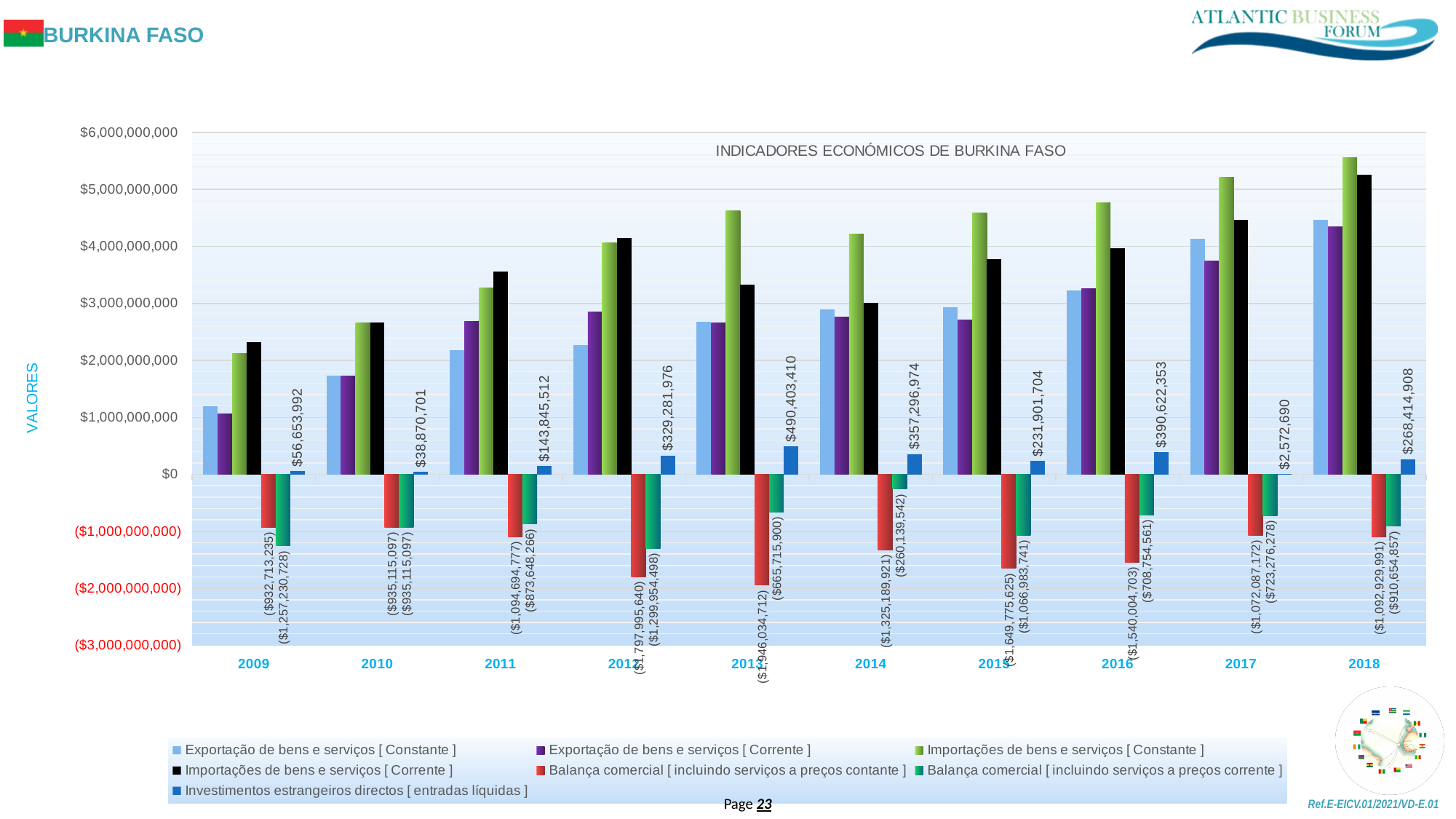
What is the title of the chart? INDICADORES ECONÓMICOS DE BURKINA FASO What is the difference between Investimentos estrangeiros directos [entradas líquidas] in 2013 and in 2014? $133,106,436 How many years are shown on the x axis? 10 In which year is Investimentos estrangeiros directos [entradas líquidas] lowest? 2017 What is the value of Balança comercial [incluindo serviços a preços corrente] in 2014? ($260,139,542) How many series does the legend list? 7 In which year is Investimentos estrangeiros directos [entradas líquidas] highest? 2013 What is the value of Balança comercial [incluindo serviços a preços contante] in 2012? ($1,797,995,640) Does Importações de bens e serviços [Constante] generally rise or fall from 2009 to 2018? Rise What kind of chart is shown on the slide? Bar chart Is the value of Importações de bens e serviços [Constante] in 2018 greater or less than $5,000,000,000? greater What is the value of Investimentos estrangeiros directos [entradas líquidas] in 2013? $490,403,410